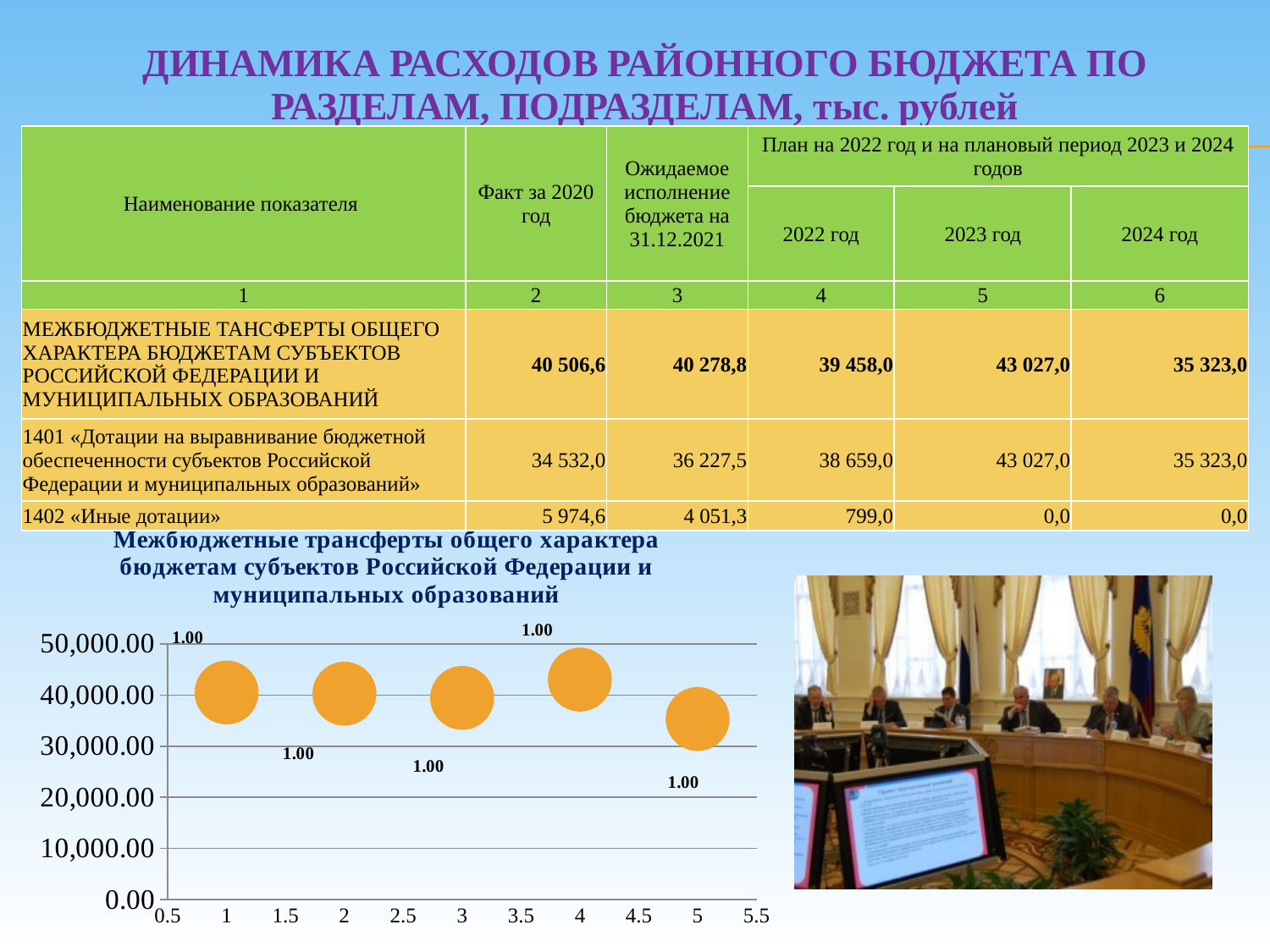
What is the title of the chart? Межбюджетные трансферты общего характера бюджетам субъектов Российской Федерации и муниципальных образований Is the value of the bubble at x = 1 greater or less than 30,000.00? greater Which bubble is higher on the chart, the one at x = 4 or the one at x = 5? x = 4 Which bubble is higher on the chart, the one at x = 1 or the one at x = 5? x = 1 At which x-axis position is the lowest bubble in the chart? 5 What is the highest tick value shown on the chart's vertical axis? 50,000.00 Is the value of the bubble at x = 4 greater or less than 40,000.00? greater Is the value of the bubble at x = 5 greater or less than 40,000.00? less What kind of chart is shown on the slide? bubble chart How many bubbles are plotted in the chart? 5 What data label is printed next to each bubble in the chart? 1.00 At which x-axis position is the highest bubble in the chart? 4